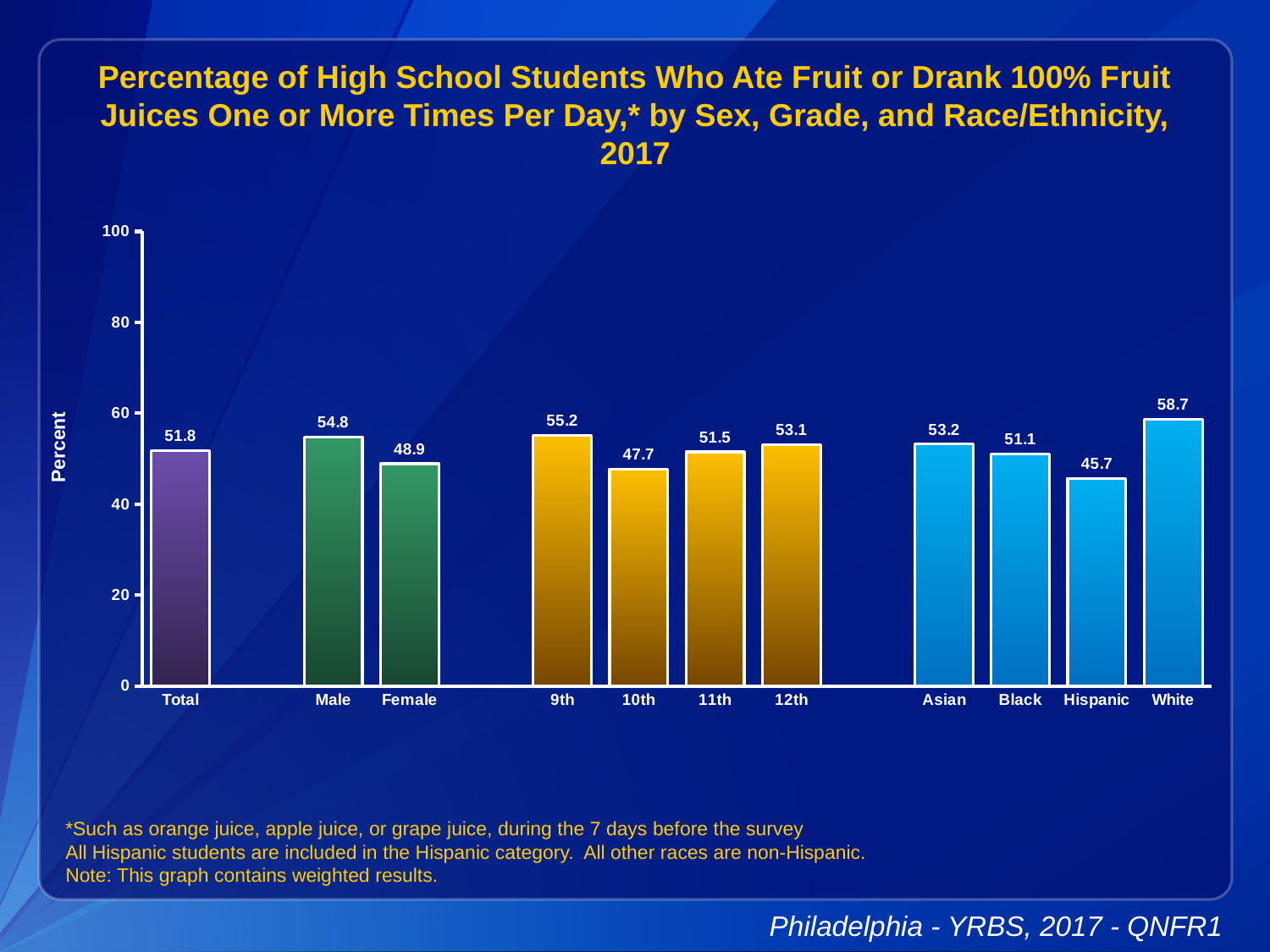
What is the difference between the White and Hispanic values? 13.0 What is the label of the y axis? Percent Which category has the highest value on the chart? White What kind of chart is shown on the slide? bar chart What is the value for Total? 51.8 Which is larger, the value for 9th grade or the value for 10th grade? 9th How many bars are shown on the chart? 11 Which category has the lowest value on the chart? Hispanic What is the difference between the Male and Female values? 5.9 What percentage of Female students ate fruit or drank 100% fruit juices one or more times per day? 48.9 Is the value for White students greater or less than 60? less What is the value for Hispanic students? 45.7